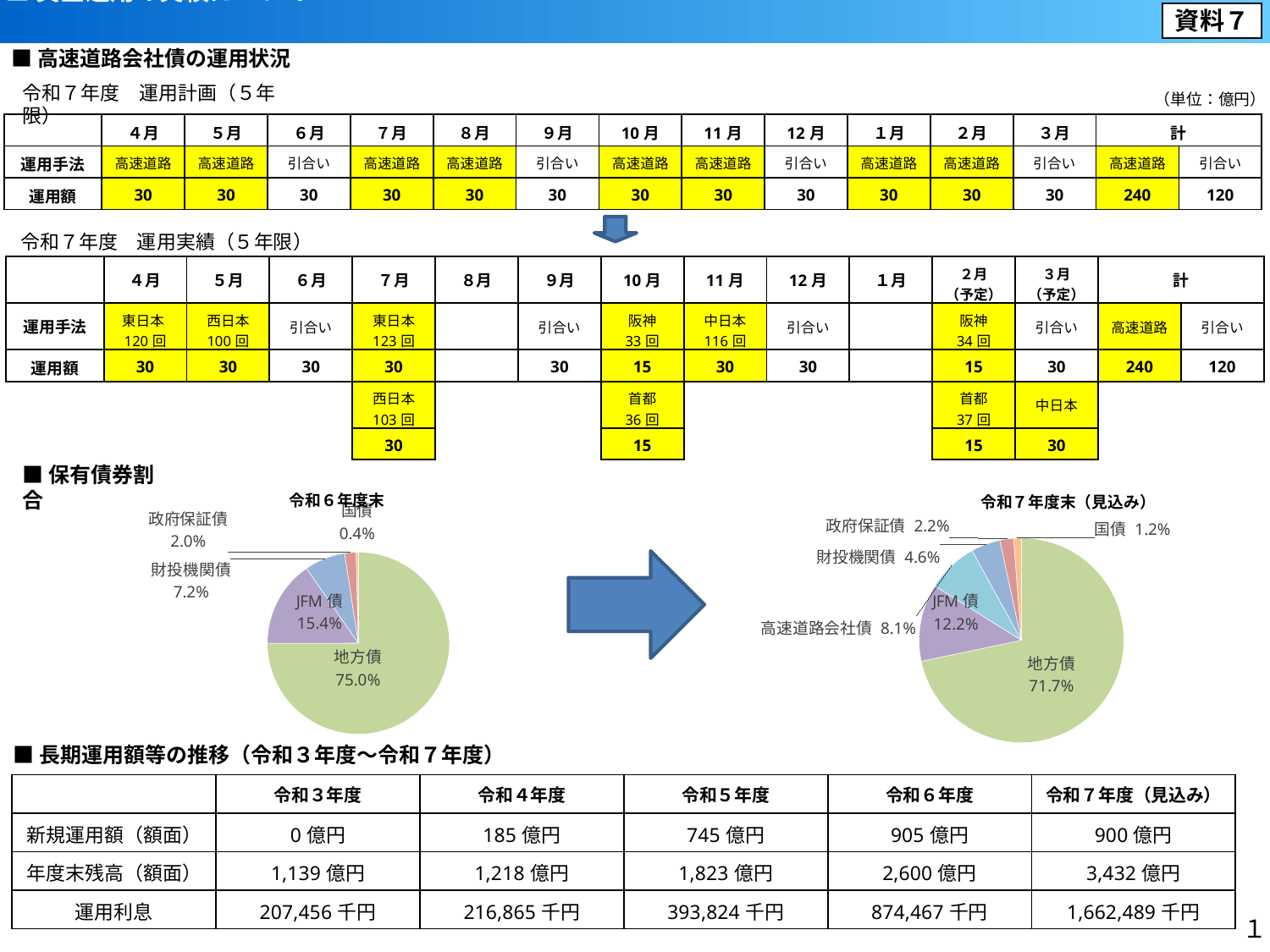
In the 令和６年度末 pie chart, what is the share of 地方債? 75.0% In the 令和７年度末（見込み） pie chart, which is larger: JFM債 or 財投機関債? JFM債 In the 令和７年度末（見込み） pie chart, which category has the largest share? 地方債 In the 令和６年度末 pie chart, what is the share of JFM債? 15.4% In the 令和６年度末 pie chart, which category has the smallest share? 国債 What type of chart is used to show 保有債券割合 on the slide? Pie chart In the 令和７年度末（見込み） pie chart, what is the share of 高速道路会社債? 8.1% In the 令和７年度末（見込み） pie chart, what is the share of 国債? 1.2% What is the difference between the share of 地方債 in the 令和６年度末 pie chart and in the 令和７年度末（見込み） pie chart? 3.3% How many categories are shown in the 令和６年度末 pie chart? 5 Which category appears in the 令和７年度末（見込み） pie chart but not in the 令和６年度末 pie chart? 高速道路会社債 How many categories are shown in the 令和７年度末（見込み） pie chart? 6